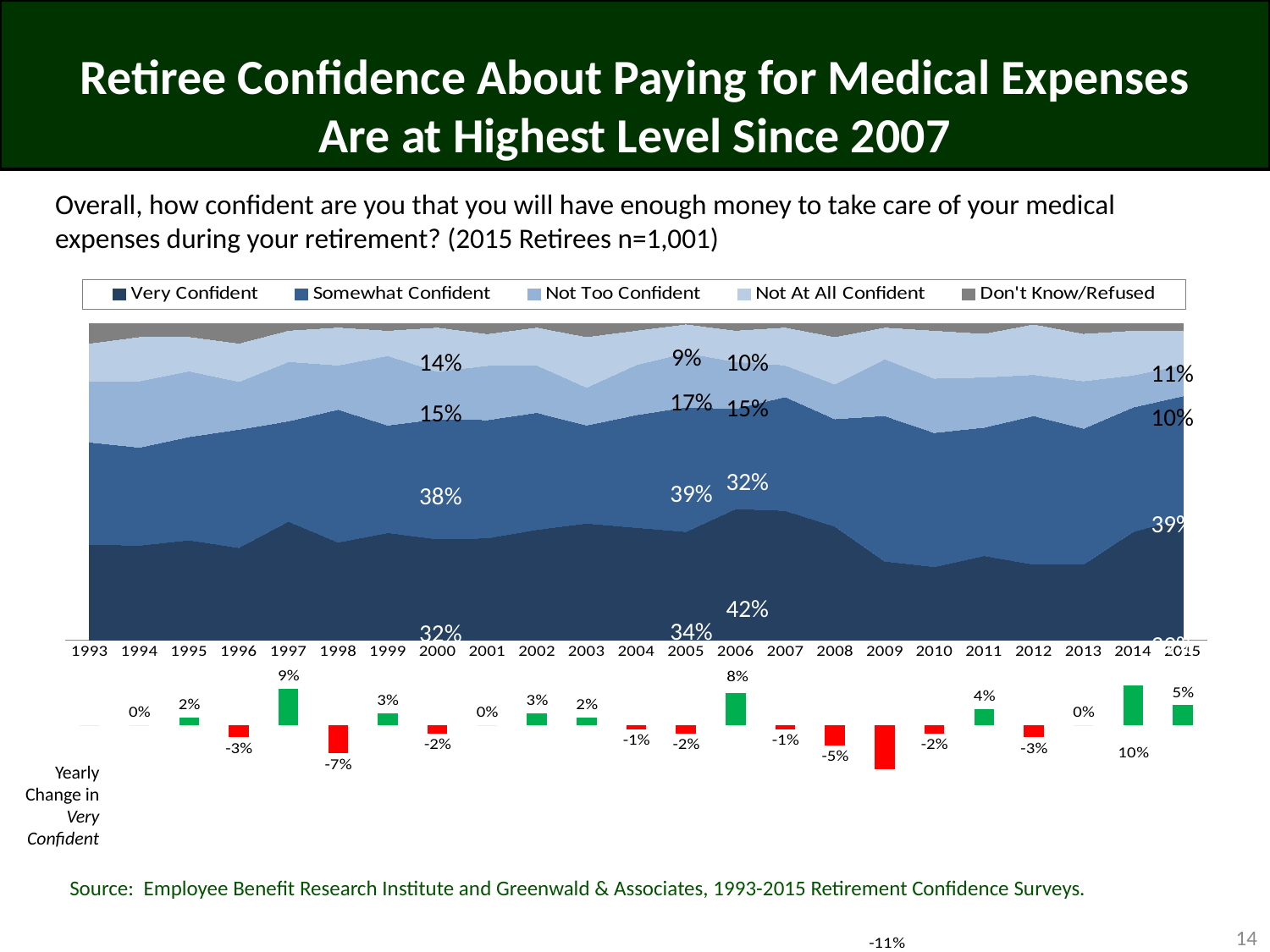
How many series does the legend of the top chart list? 5 What kind of chart is the top chart on the slide? stacked area chart In the top chart, what percentage of retirees were Somewhat Confident in 2005? 39% In the bottom chart, what is the yearly change in Very Confident for 1997? 9% In the top chart, what percentage of retirees were Very Confident in 2000? 32% In the top chart, what percentage of retirees were Very Confident in 2006? 42% In the bottom chart, what is the yearly change in Very Confident for 1998? -7% What kind of chart is the bottom chart showing the yearly change in Very Confident? bar chart In the top chart, what percentage of retirees were Not At All Confident in 2015? 11% In the top chart, by how much did the Very Confident share in 2006 exceed the Very Confident share in 2000? 10% In the bottom chart, which year has the largest positive yearly change in Very Confident? 2014 In the top chart for 2006, which is larger: the Very Confident share or the Somewhat Confident share? Very Confident